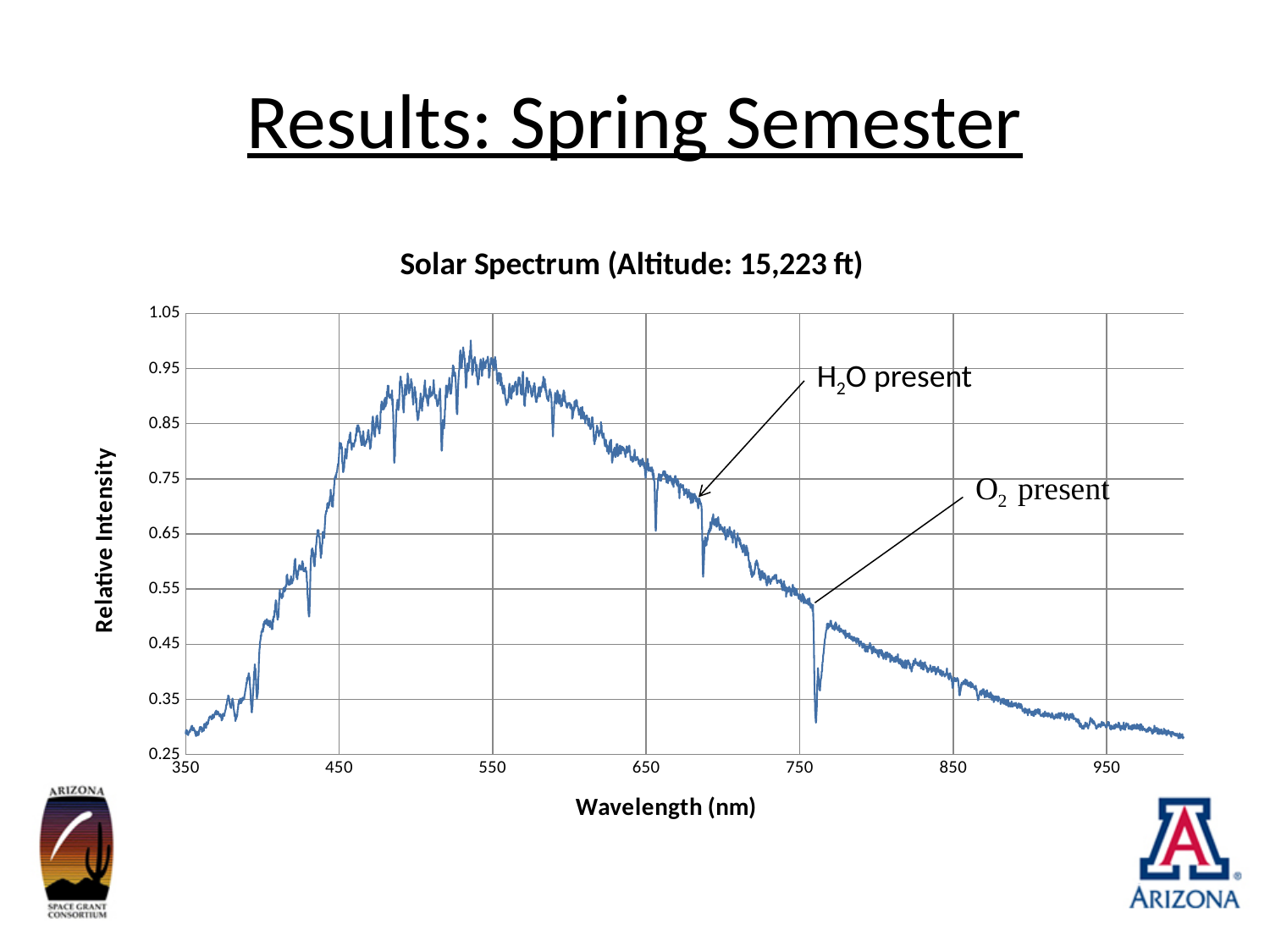
What kind of chart is shown on the slide? line chart Which has the higher relative intensity, the value at 550 nm or the value at 850 nm? 550 nm Which molecule is labelled as present at the sharp dip near 760 nm? O2 Is the peak relative intensity of the spectrum greater or less than 0.95? greater Is the relative intensity at 850 nm greater or less than 0.45? less Is the relative intensity at 750 nm greater or less than 0.45? greater Does the relative intensity rise or fall as wavelength increases from 550 nm to 950 nm? fall What is the title of the chart? Solar Spectrum (Altitude: 15,223 ft) Does the relative intensity rise or fall as wavelength increases from 350 nm to 550 nm? rise